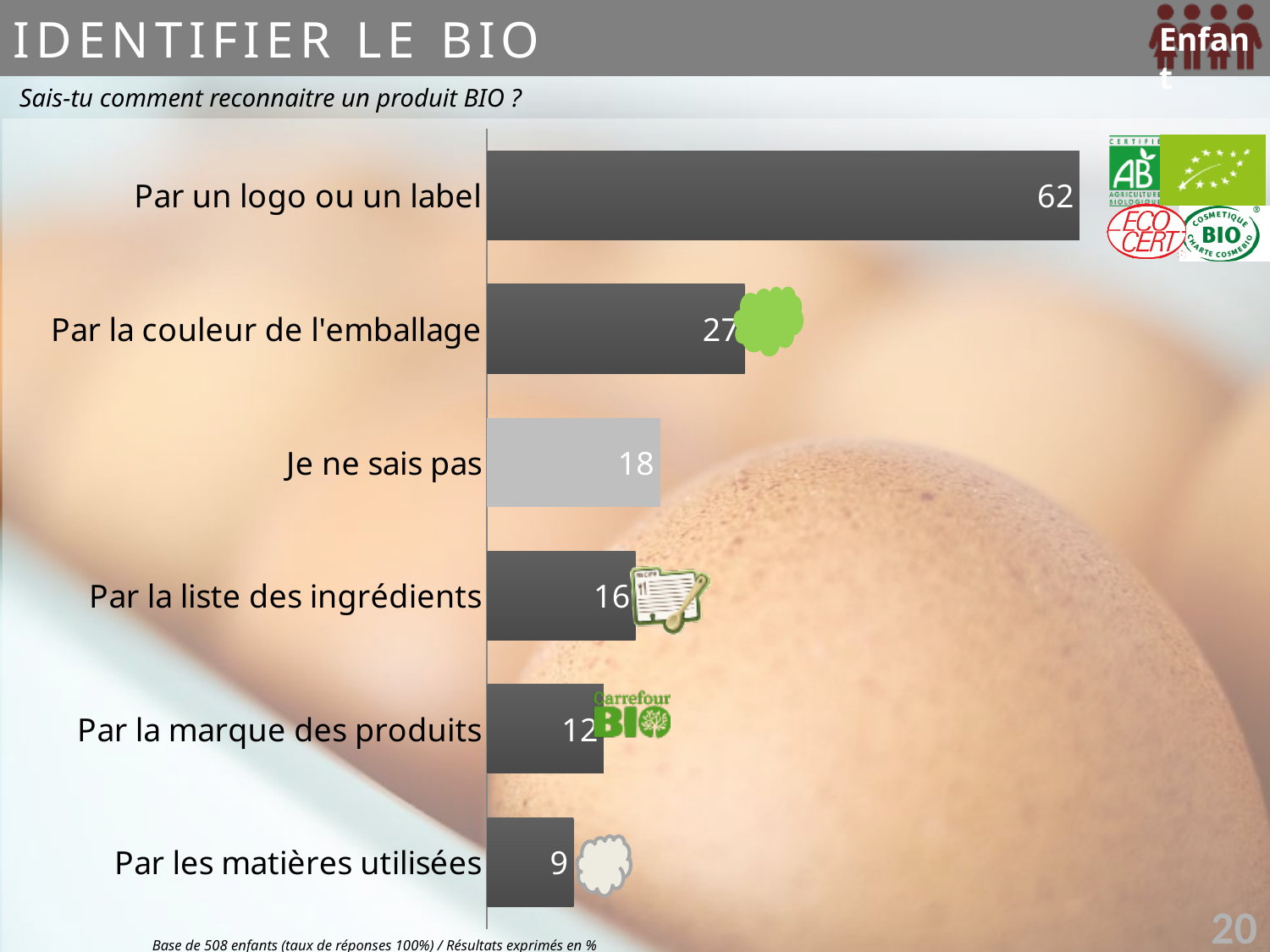
How many categories are shown in the chart? 6 What is the value for "Par un logo ou un label"? 62 What kind of chart is shown on the slide? Bar chart What is the value for "Par la liste des ingrédients"? 16 What is the difference between the values for "Par un logo ou un label" and "Par la couleur de l'emballage"? 35 Which is larger: the value for "Je ne sais pas" or the value for "Par la marque des produits"? Je ne sais pas Which category has the highest value? Par un logo ou un label What is the value for "Par la marque des produits"? 12 What is the value for "Par les matières utilisées"? 9 What is the value for "Par la couleur de l'emballage"? 27 What is the value for "Je ne sais pas"? 18 Which category has the lowest value? Par les matières utilisées